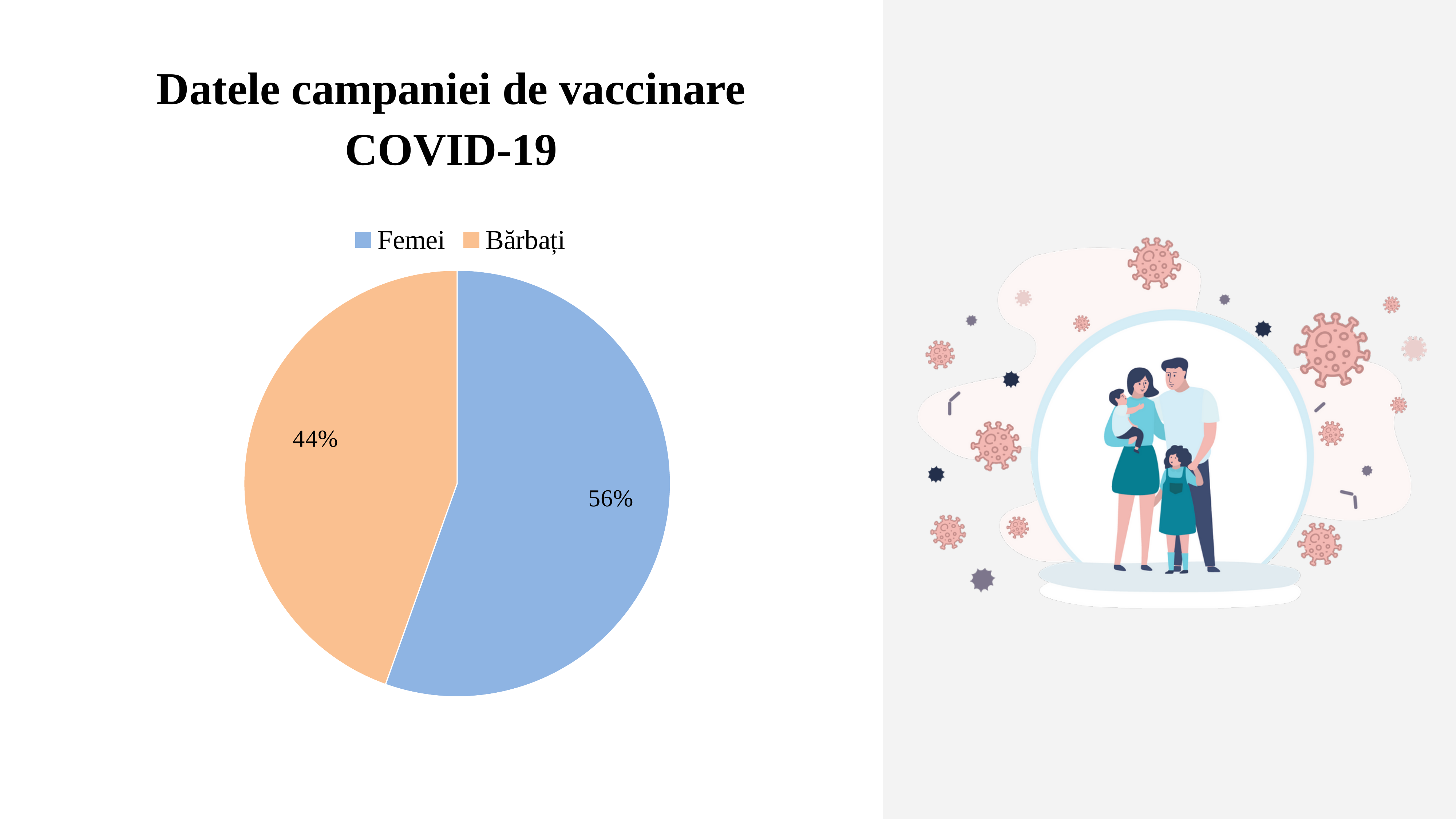
Is the Femei share greater or less than 50%? greater Which category has the smaller slice of the pie chart? Bărbați How many slices does the pie chart have? 2 What kind of chart is shown on the slide? pie chart What share of the pie chart is labelled Bărbați? 44% What is the difference in percentage points between the Femei and Bărbați slices? 12 Is the Femei slice larger or smaller than the Bărbați slice? larger How many entries does the chart legend list? 2 Which category has the larger slice of the pie chart? Femei What is the title shown above the chart? Datele campaniei de vaccinare COVID-19 What colour is the Bărbați slice in the pie chart? orange What share of the pie chart is labelled Femei? 56%